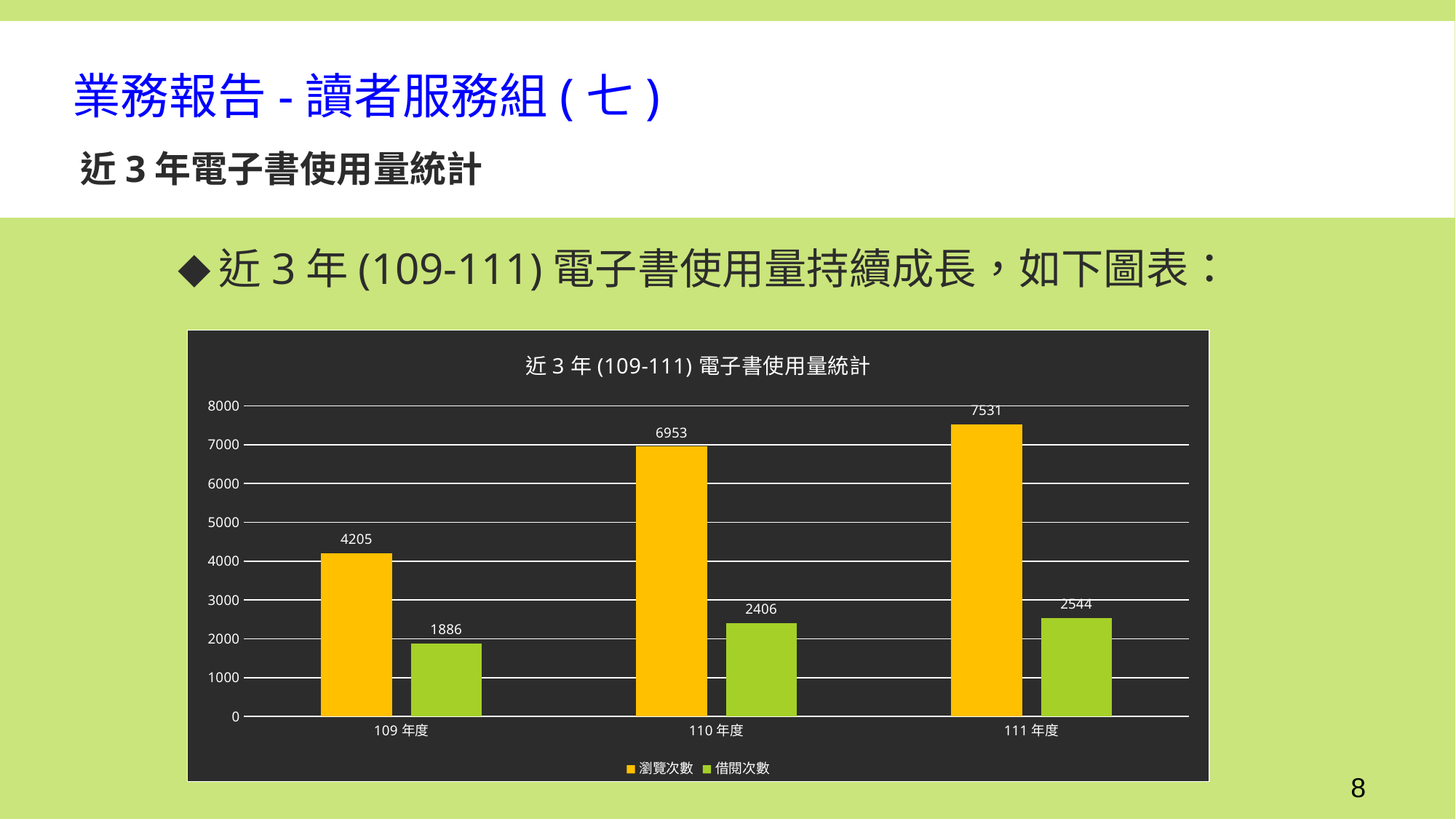
What is the 借閱次數 value for 111 年度? 2544 How many series does the legend list? 2 What is the difference between the 瀏覽次數 for 111 年度 and 110 年度? 578 Do the 借閱次數 values rise or fall from 109 年度 to 111 年度? rise What kind of chart is shown on the slide? bar chart Which year has the highest 瀏覽次數? 111 年度 What is the 瀏覽次數 value for 110 年度? 6953 Which is larger: the 借閱次數 for 110 年度 or the 借閱次數 for 111 年度? 111 年度 Which year has the lowest 借閱次數? 109 年度 What is the 瀏覽次數 value for 109 年度? 4205 Is the 瀏覽次數 for 111 年度 greater or less than 7000? greater How many year categories are shown on the x axis? 3